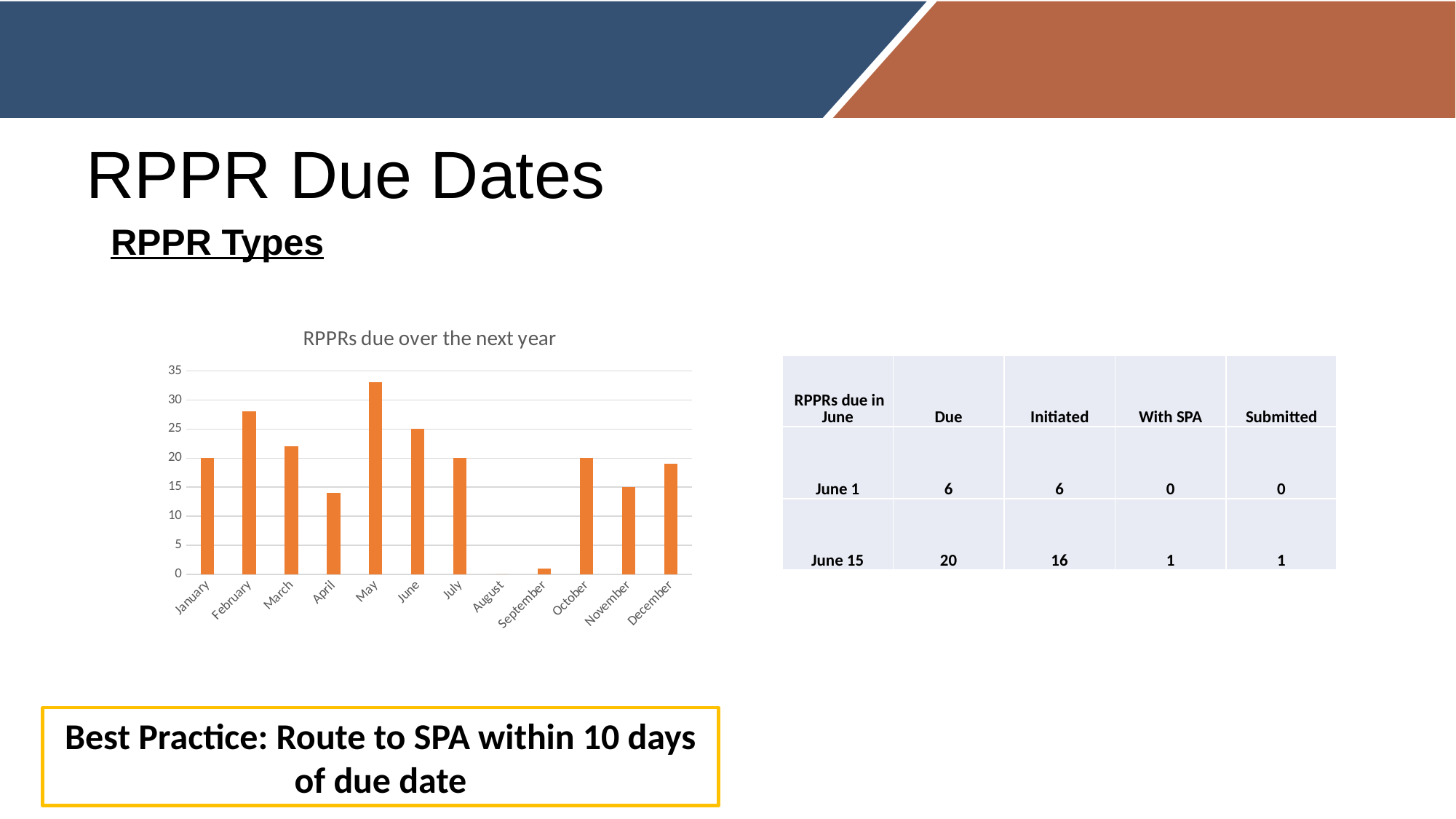
Which month has more RPPRs due, February or March? February What type of chart is shown on the slide? bar chart Which month has the lowest number of RPPRs due? August Is the value for May greater or less than 30? greater Which month has the highest number of RPPRs due? May Is the value for April greater or less than 15? less Is the value for February greater or less than 25? greater What is the title of the chart? RPPRs due over the next year Which month has more RPPRs due, June or November? June What colour are the bars in the chart? orange How many months are shown on the x axis of the chart? 12